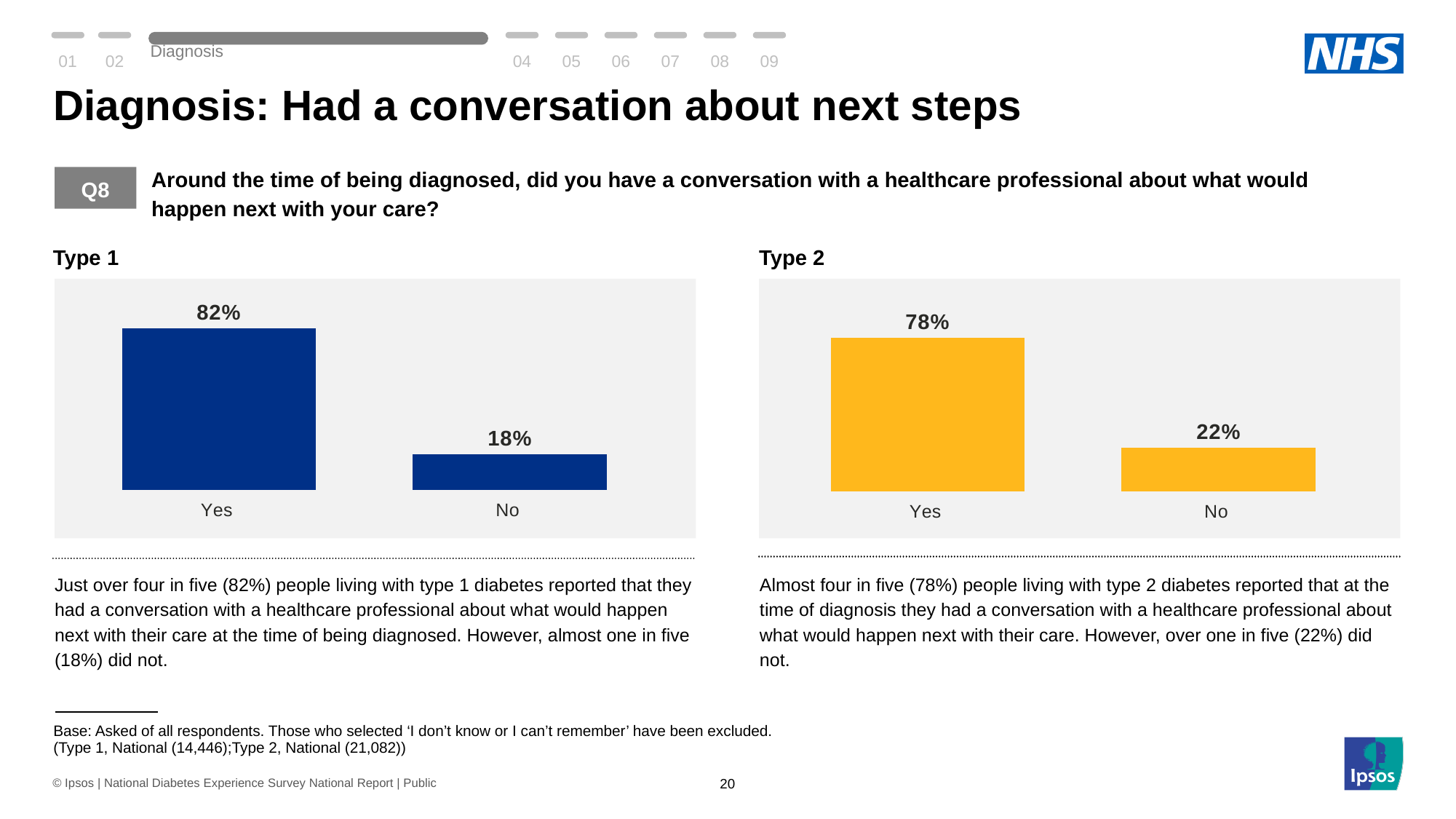
In the Type 2 chart, what percentage of respondents answered Yes? 78% In the Type 2 chart, what is the difference between the Yes and No values? 56% In the Type 1 chart, what is the difference between the Yes and No values? 64% What kind of chart is the Type 1 chart? Bar chart How many categories are shown in the Type 2 chart? 2 In the Type 1 chart, what percentage of respondents answered Yes? 82% In the Type 1 chart, which category has the highest value? Yes What colour are the bars in the Type 2 chart? Yellow In the Type 2 chart, what percentage of respondents answered No? 22% Is the Yes value larger in the Type 1 chart or the Type 2 chart? Type 1 In the Type 1 chart, what percentage of respondents answered No? 18% In the Type 2 chart, which category has the lowest value? No